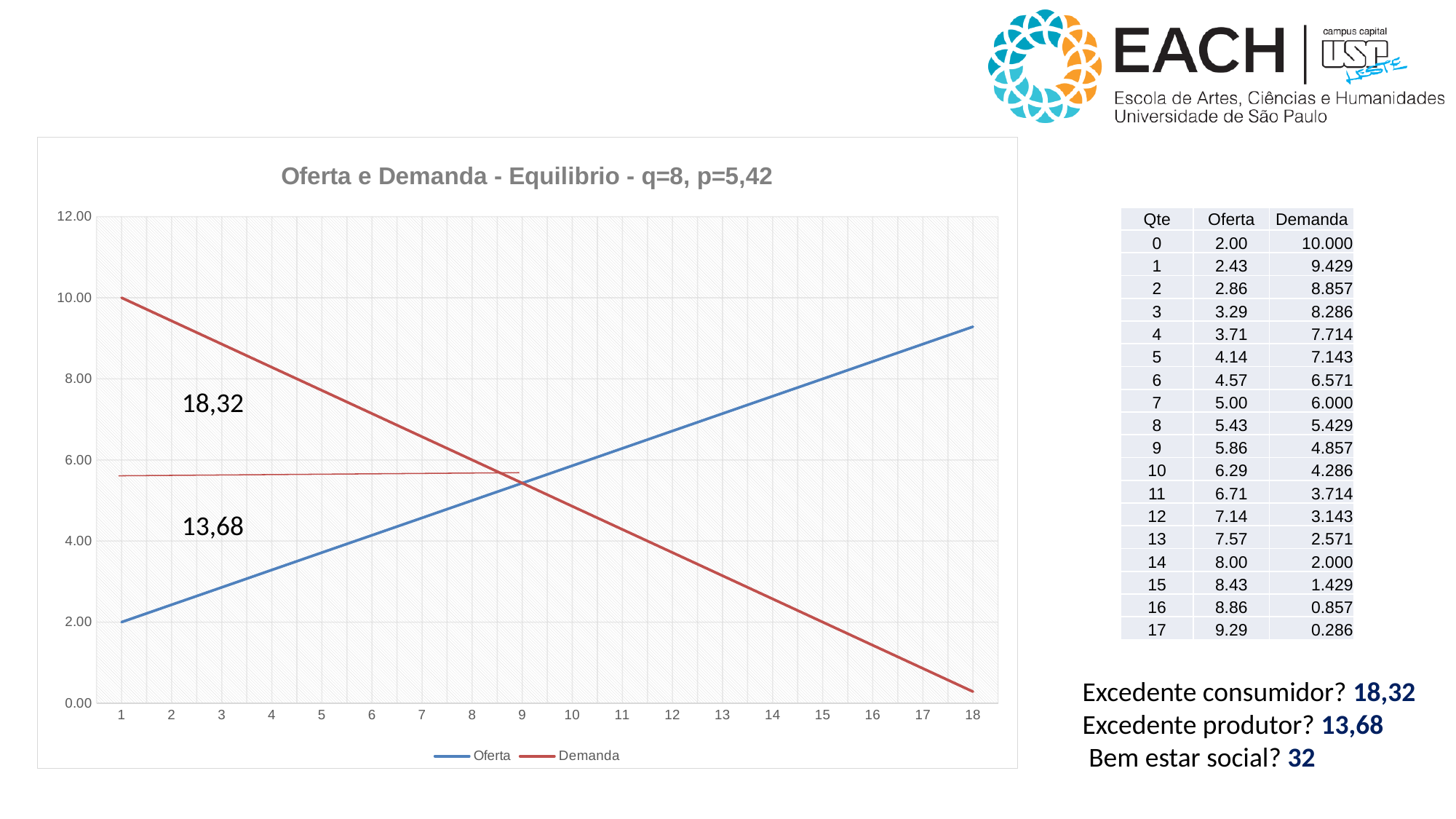
Does the Demanda line rise or fall as the x-axis value increases? falls How many x-axis points are plotted on the chart? 18 At which x-axis value does the Demanda line reach its highest point? 1 What is the value of the Oferta line at x = 1? 2.00 Is the Demanda value at x = 5 greater or less than 6.00? greater What is the title of the chart? Oferta e Demanda - Equilibrio - q=8, p=5,42 How many series does the chart legend list? 2 What kind of chart is shown on the slide? line chart What are the two series named in the chart legend? Oferta and Demanda At x = 12, which line is higher, Oferta or Demanda? Oferta Is the Oferta value at x = 3 greater or less than 4.00? less Does the Oferta line rise or fall as the x-axis value increases? rises